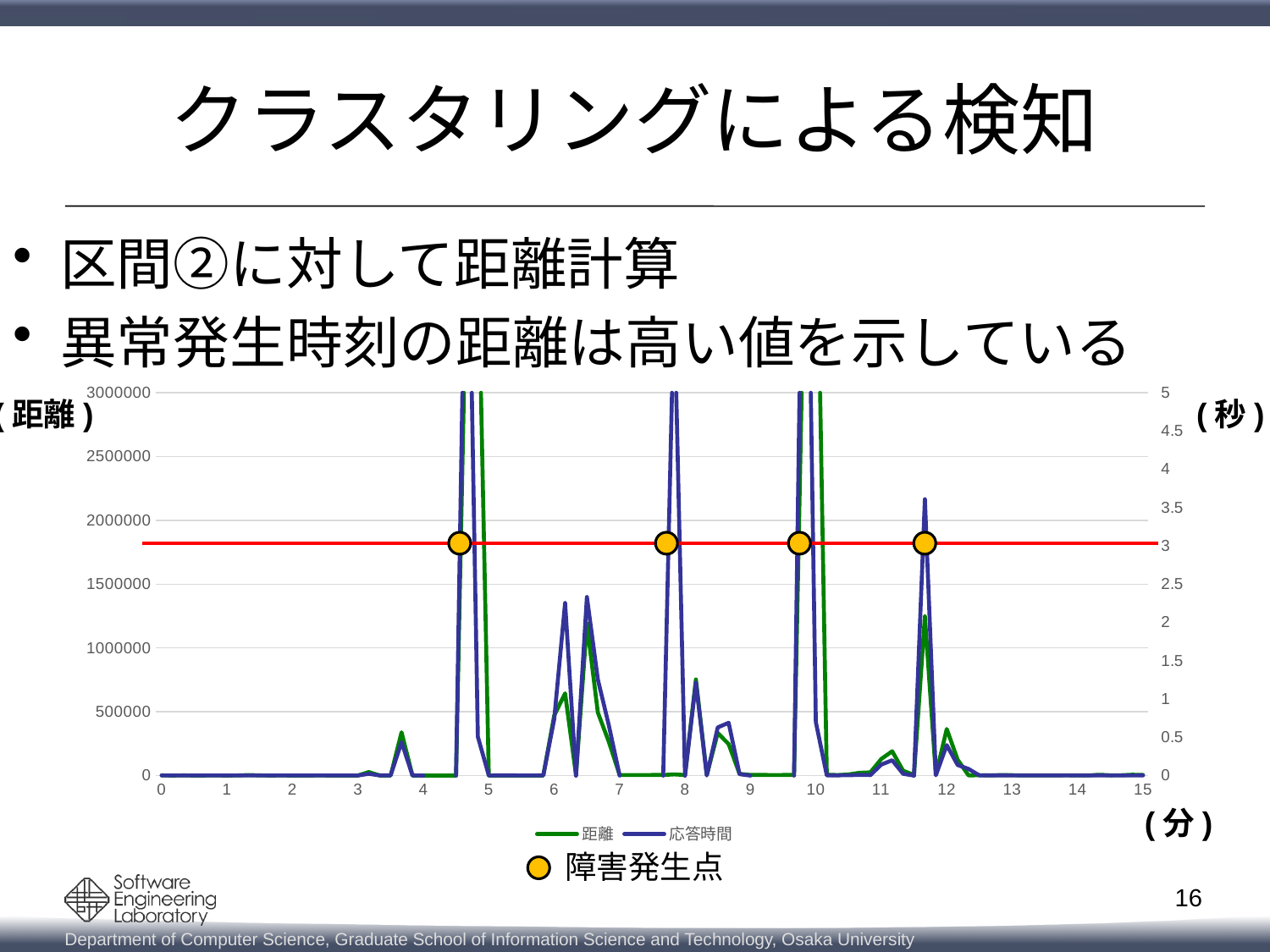
Which colour is used for the 距離 series in the chart? green How many series does the chart legend list? 2 What is the maximum value shown on the right vertical axis of the chart? 5 What is the maximum value shown on the left vertical axis of the chart? 3000000 Is the 応答時間 value at x = 11.7 greater or less than 3 on the right axis? greater Is the 距離 value at x = 3 greater or less than 500000 on the left axis? less What is the last tick value shown on the horizontal axis of the chart? 15 What kind of chart is shown on the slide? line chart How many 障害発生点 (orange circle markers) are shown on the chart? 4 What are the two series named in the chart legend? 距離 and 応答時間 Is the 応答時間 value at x = 6.2 greater or less than 3 on the right axis? less On the right axis, at what value does the red horizontal line sit? 3